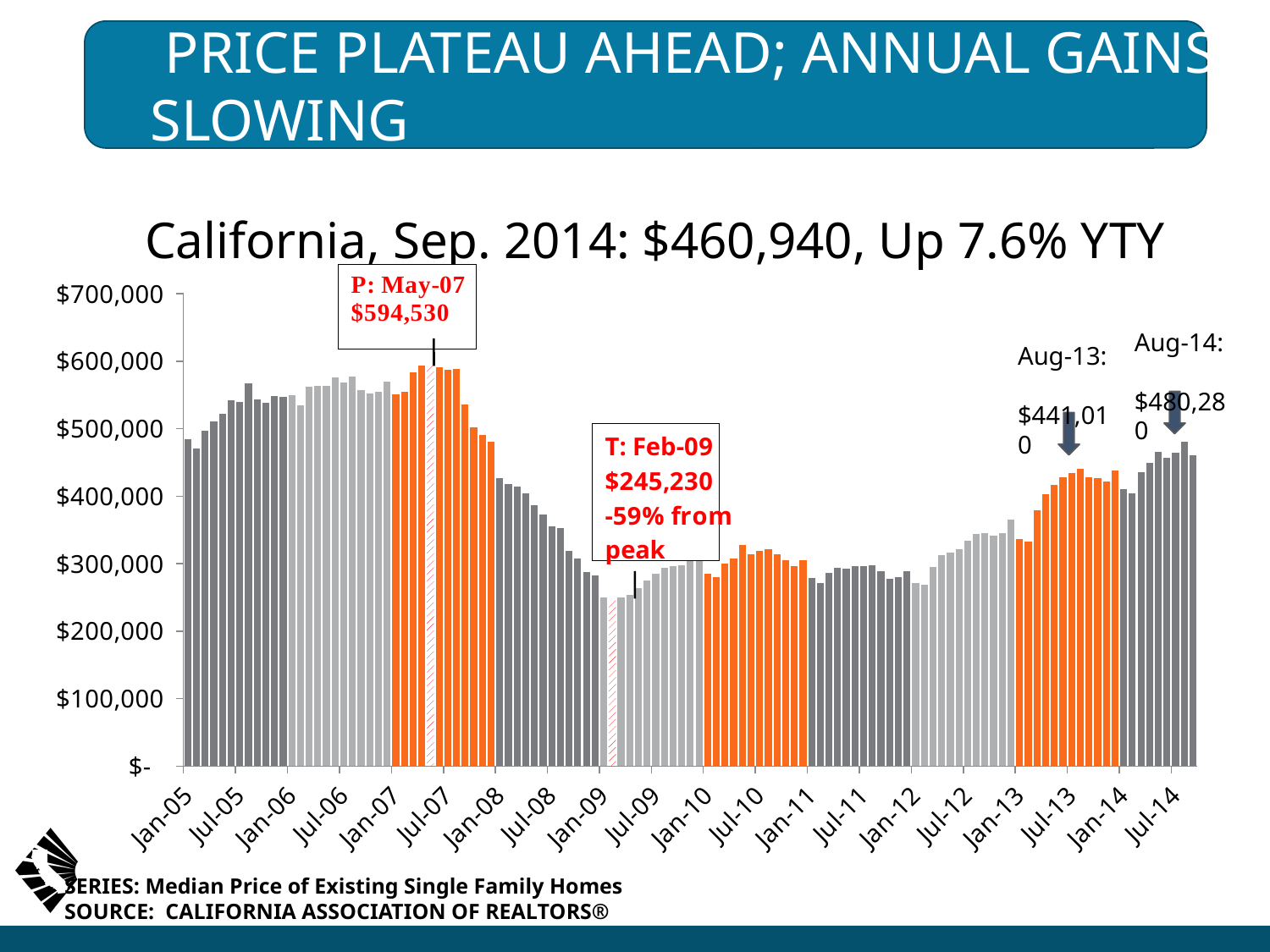
According to the chart title, what was the California median price in Sep. 2014? $460,940 What was the peak median price in May-07 according to the annotation? $594,530 How much higher is the Aug-14 median price than the Aug-13 median price? $39,270 Did the median price rise or fall between May-07 and Feb-09? fall What kind of chart is shown on the slide? bar chart What median price is labeled for Aug-14? $480,280 Is the median price for Jan-05 greater or less than $400,000? greater In which month did the median price reach its peak? May-07 What median price is labeled for Aug-13? $441,010 What was the trough median price in Feb-09 according to the annotation? $245,230 In which month did the median price reach its trough? Feb-09 What is the difference between the May-07 peak and the Feb-09 trough? $349,300